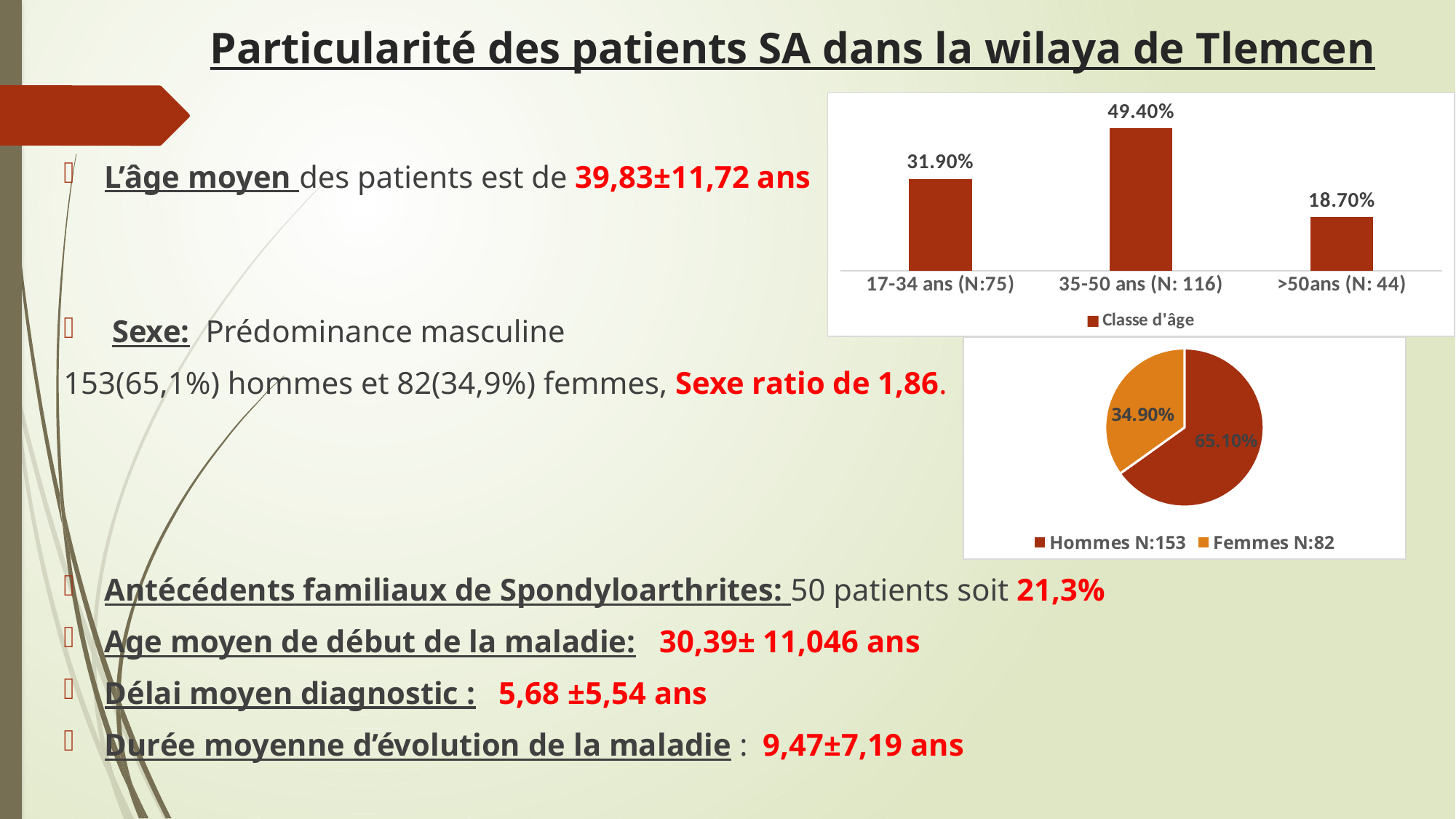
In the pie chart, what share is shown for Femmes N:82? 34.90% In the bar chart at the top right, what is the value for the 35-50 ans (N: 116) category? 49.40% In the bar chart at the top right, what is the legend entry? Classe d'âge In the bar chart at the top right, what is the value for the 17-34 ans (N:75) category? 31.90% In the bar chart at the top right, which age class has the highest value? 35-50 ans (N: 116) In the pie chart, what share is shown for Hommes N:153? 65.10% In the bar chart at the top right, what is the difference between the values for 35-50 ans and >50ans? 30.70% In the bar chart at the top right, which age class has the lowest value? >50ans (N: 44) What type of chart is the chart at the top right of the slide? Bar chart In the bar chart at the top right, how many age classes are shown? 3 How many entries does the legend of the pie chart list? 2 In the pie chart, which slice is larger, Hommes or Femmes? Hommes